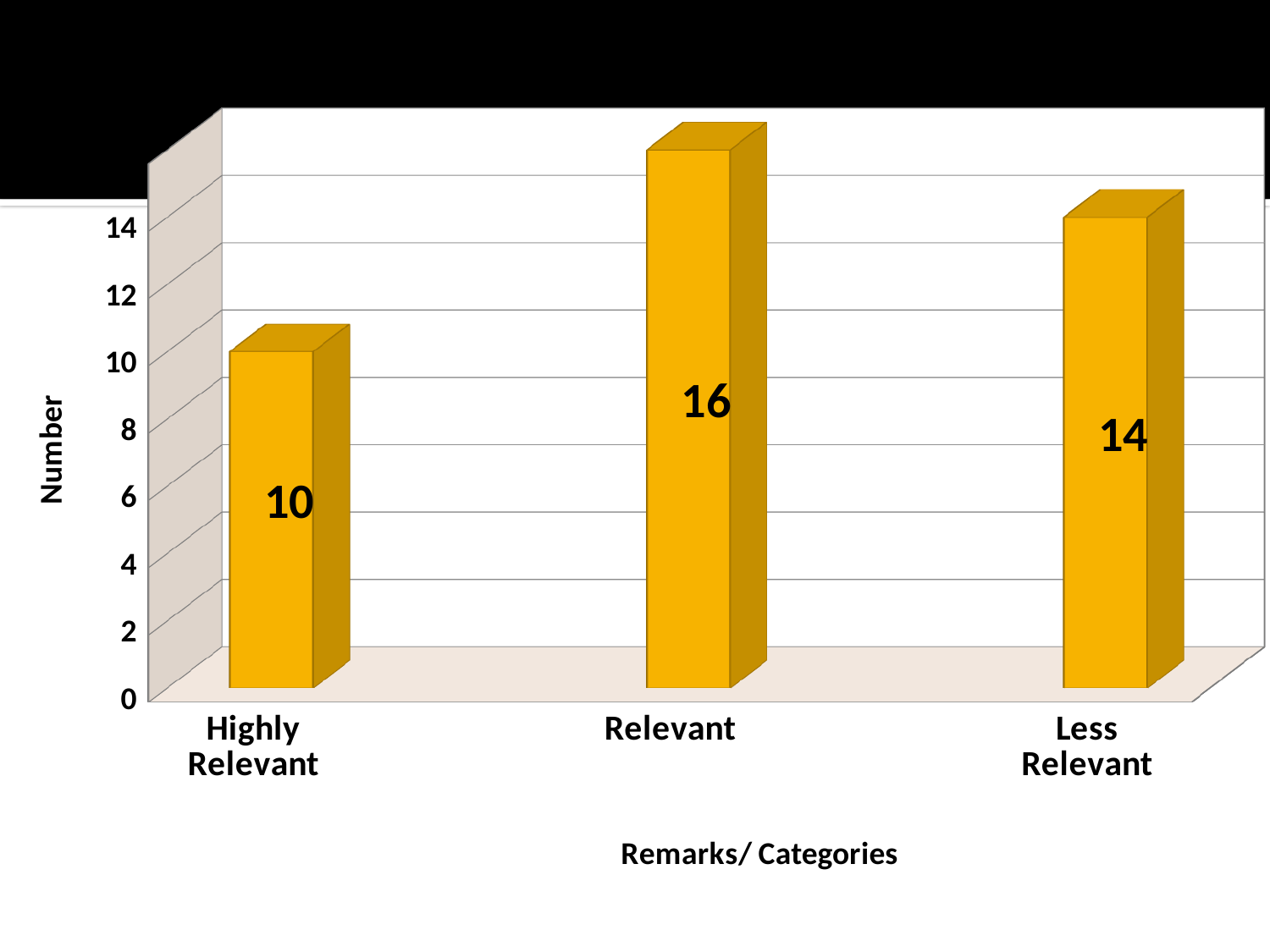
What is the value for Less Relevant? 14 How many categories are shown on the x axis? 3 What is the value for Highly Relevant? 10 Is the value for Less Relevant greater or less than 12? greater Which category has the highest value? Relevant Which category has the lowest value? Highly Relevant What is the value for Relevant? 16 Which is larger, the value for Less Relevant or the value for Highly Relevant? Less Relevant What is the label of the x axis? Remarks/ Categories What is the difference between the values for Relevant and Highly Relevant? 6 What is the difference between the values for Relevant and Less Relevant? 2 What kind of chart is shown on the slide? bar chart